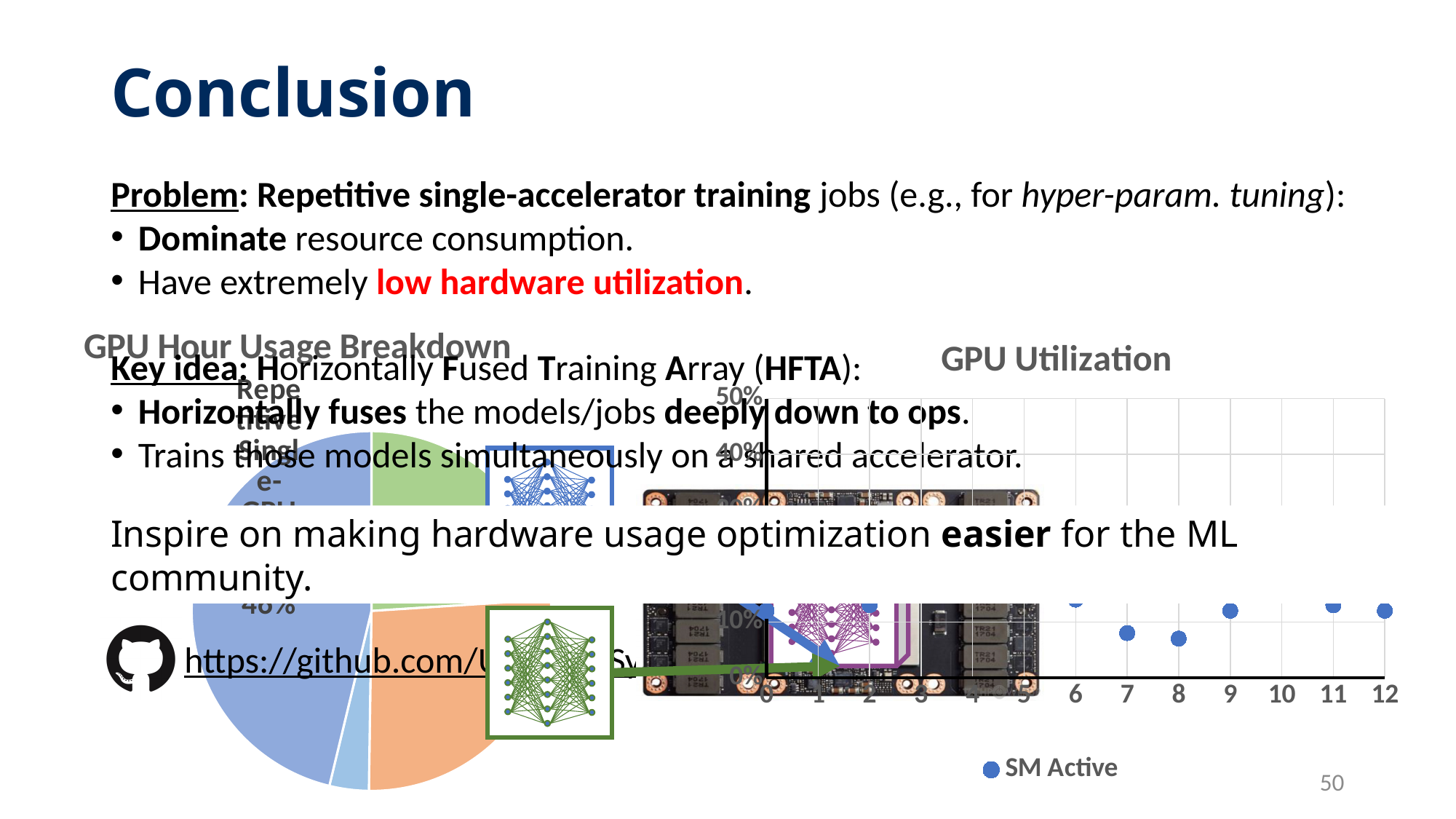
What kind of chart is the "GPU Utilization" chart? scatter chart What kind of chart is the "GPU Hour Usage Breakdown" chart? pie chart How many series does the legend of the "GPU Utilization" chart list? 1 In the "GPU Utilization" chart, what series does the legend list? SM Active In the "GPU Utilization" chart, what is the highest value shown on the y axis? 50% In the "GPU Utilization" chart, is the SM Active value at x = 12 greater or less than 40%? less In the "GPU Utilization" chart, is the SM Active value at x = 8 greater or less than 10%? less